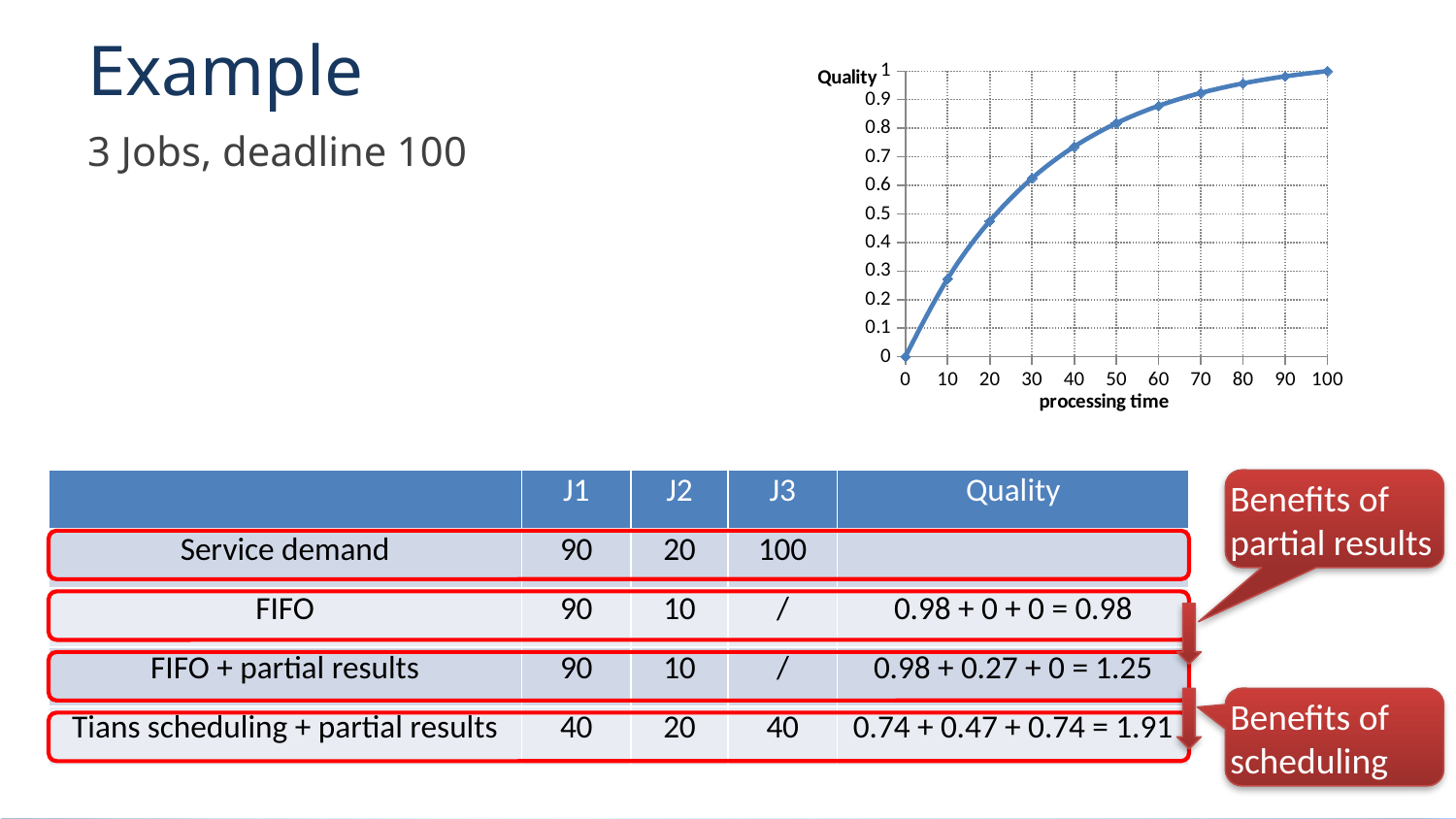
Is the quality at processing time 10 greater or less than 0.4? less Is the quality at processing time 40 greater or less than 0.7? greater What is the label of the y axis of the chart? Quality What is the label of the x axis of the chart? processing time What is the quality value at processing time 100? 1 At which processing time is the quality lowest? 0 At which processing time is the quality highest? 100 Is the quality at processing time 20 greater or less than 0.4? greater How many data points are plotted on the chart? 11 What kind of chart is shown on the slide? line chart What is the quality value at processing time 0? 0 Does the quality rise or fall as processing time increases along the x axis? rises